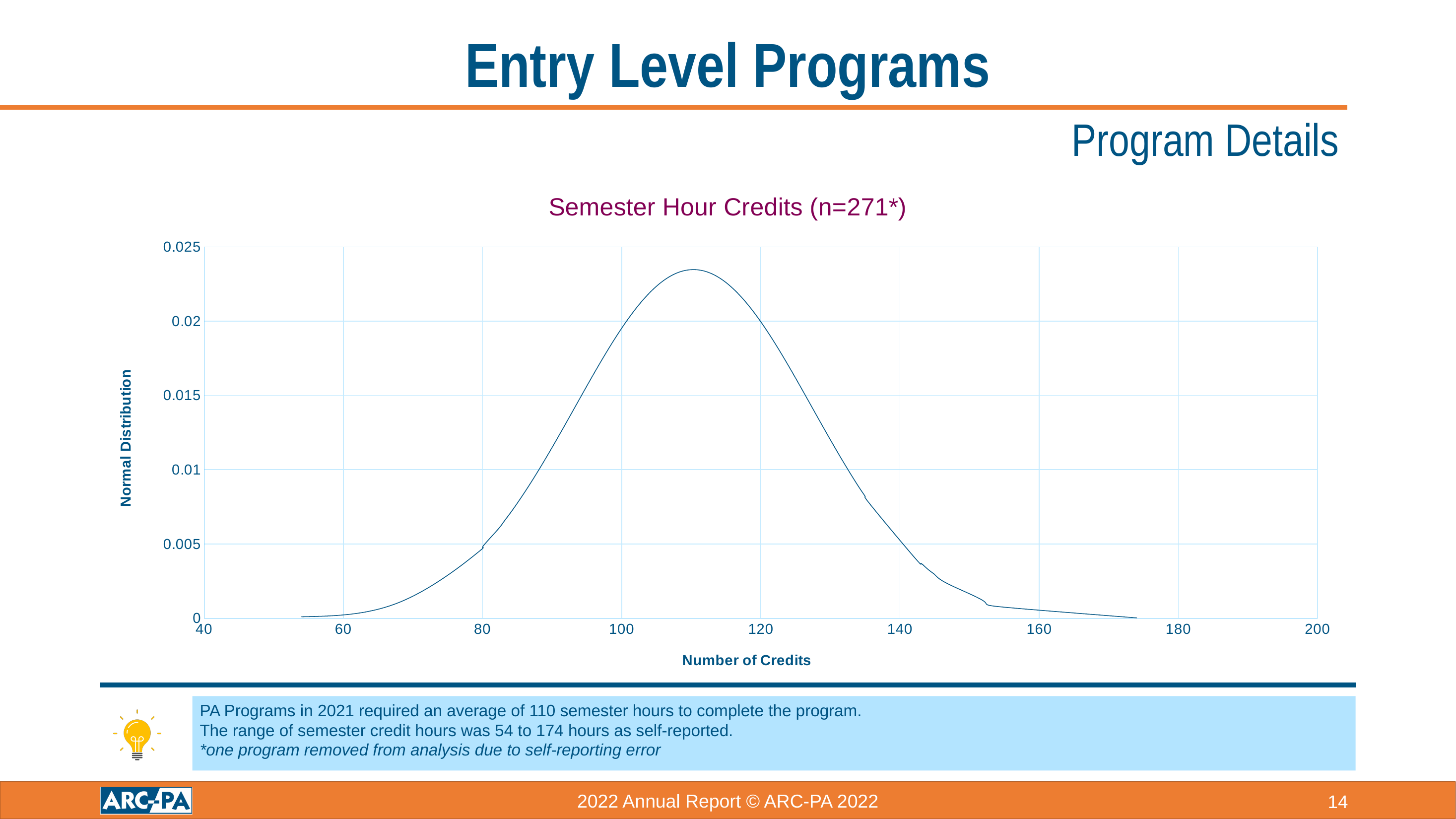
Is the value of the curve at 100 credits greater or less than 0.015? greater How many lines (series) are plotted on the chart? 1 What is the title of the x axis of the chart? Number of Credits Between 60 and 100 credits, does the curve rise or fall? rise Is the value of the curve at 140 credits greater or less than 0.01? less What kind of chart is shown on the slide? line chart Is the value of the curve at 80 credits greater or less than 0.01? less Between 120 and 160 credits, does the curve rise or fall? fall What is the title of the chart? Semester Hour Credits (n=271*)